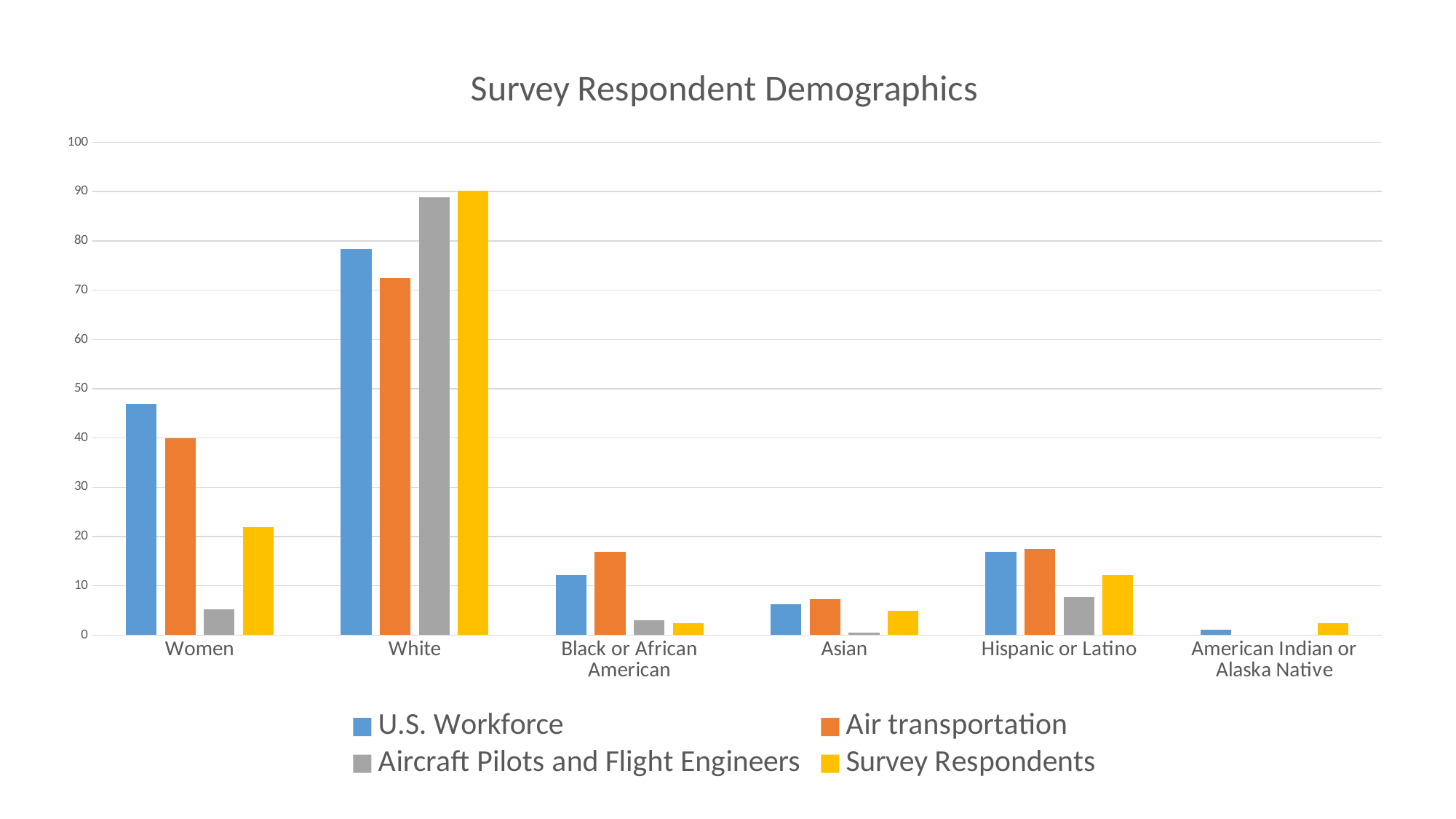
For Women, which is larger: Survey Respondents or Aircraft Pilots and Flight Engineers? Survey Respondents How many series does the legend list? 4 What kind of chart is shown on the slide? bar chart For White, which is larger: U.S. Workforce or Air transportation? U.S. Workforce Is the U.S. Workforce value for Women greater or less than 40? greater Which category has the highest Survey Respondents value? White Which category has the lowest U.S. Workforce value? American Indian or Alaska Native Is the Aircraft Pilots and Flight Engineers value for White greater or less than 80? greater For Black or African American, which is larger: Air transportation or U.S. Workforce? Air transportation How many categories are shown on the x axis? 6 Is the Air transportation value for White greater or less than 70? greater What is the title of the chart? Survey Respondent Demographics